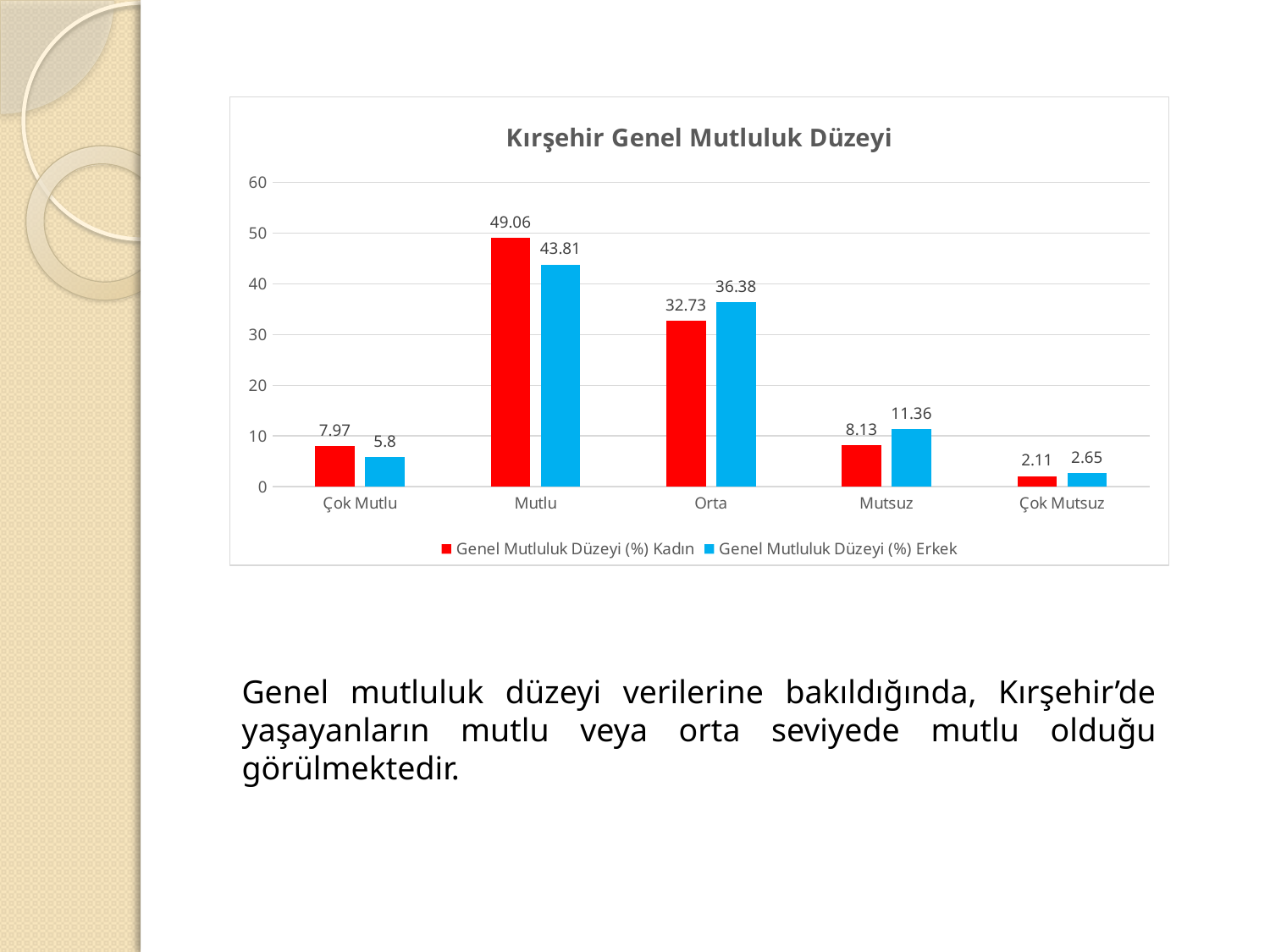
What is the difference between the Erkek and Kadın values in the Mutsuz category? 3.23 In the Orta category, which is larger, the Kadın value or the Erkek value? Erkek Which category has the highest value for the Kadın series? Mutlu How many categories are shown on the x axis? 5 Is the Kadın value for Orta greater or less than 30? greater What is the difference between the Kadın and Erkek values in the Mutlu category? 5.25 What is the value for Kadın in the Mutlu category? 49.06 What is the title of the chart? Kırşehir Genel Mutluluk Düzeyi How many series does the legend list? 2 Which category has the lowest value for the Erkek series? Çok Mutsuz What is the value for Erkek in the Orta category? 36.38 What is the value for Erkek in the Çok Mutlu category? 5.8